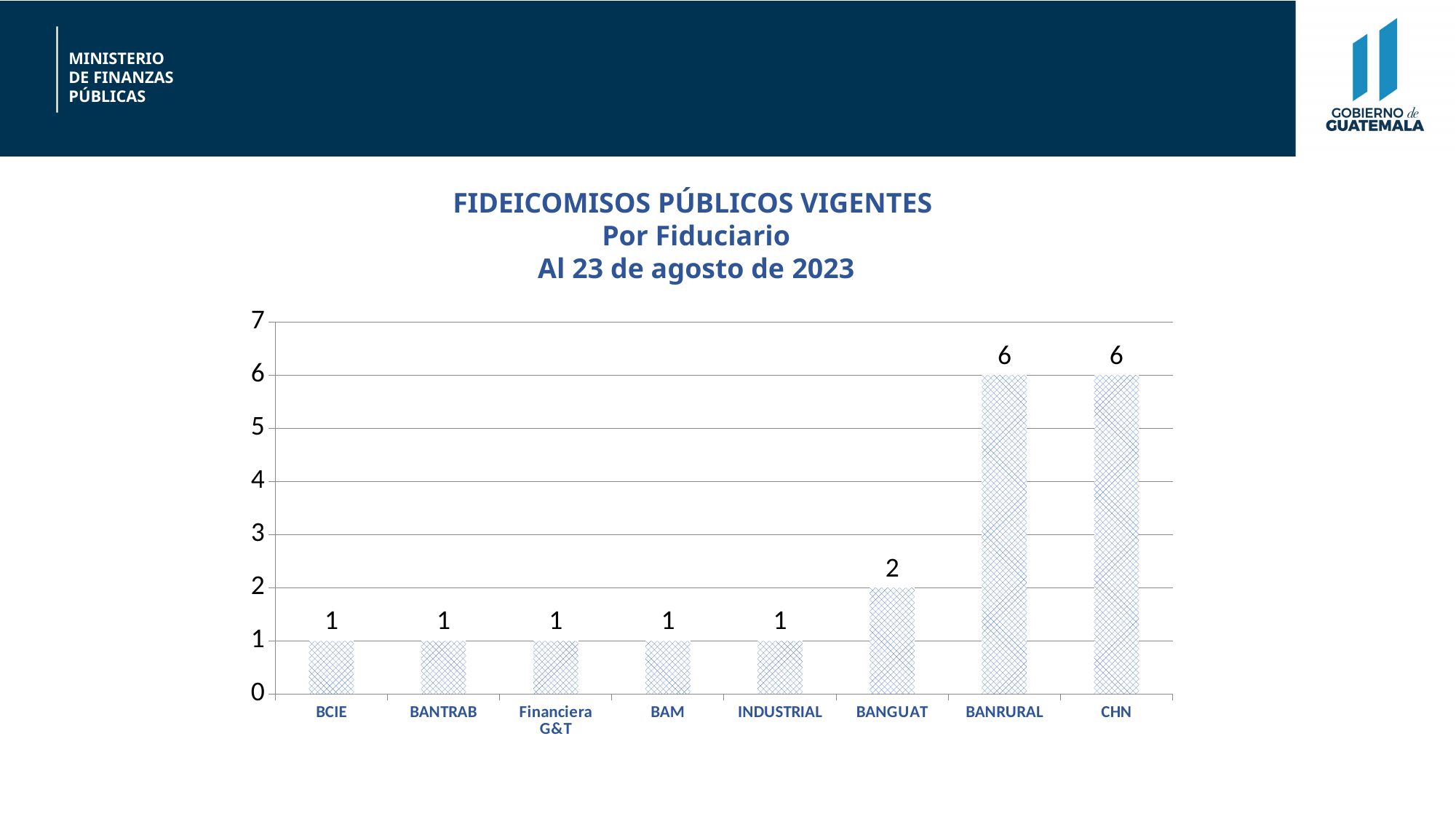
What is the value for CHN? 6 What is the value for Financiera G&T? 1 What is the title of the chart? FIDEICOMISOS PÚBLICOS VIGENTES Por Fiduciario Al 23 de agosto de 2023 What is the value for BANGUAT? 2 How many categories are shown on the x axis? 8 Is the value for CHN greater or less than 5? greater Which is larger, the value for BANGUAT or the value for INDUSTRIAL? BANGUAT What is the difference between the values for BANRURAL and BANGUAT? 4 What is the value for BANRURAL? 6 Which two categories share the highest value on the chart? BANRURAL and CHN What is the difference between the values for BANGUAT and BCIE? 1 What kind of chart is shown on the slide? bar chart